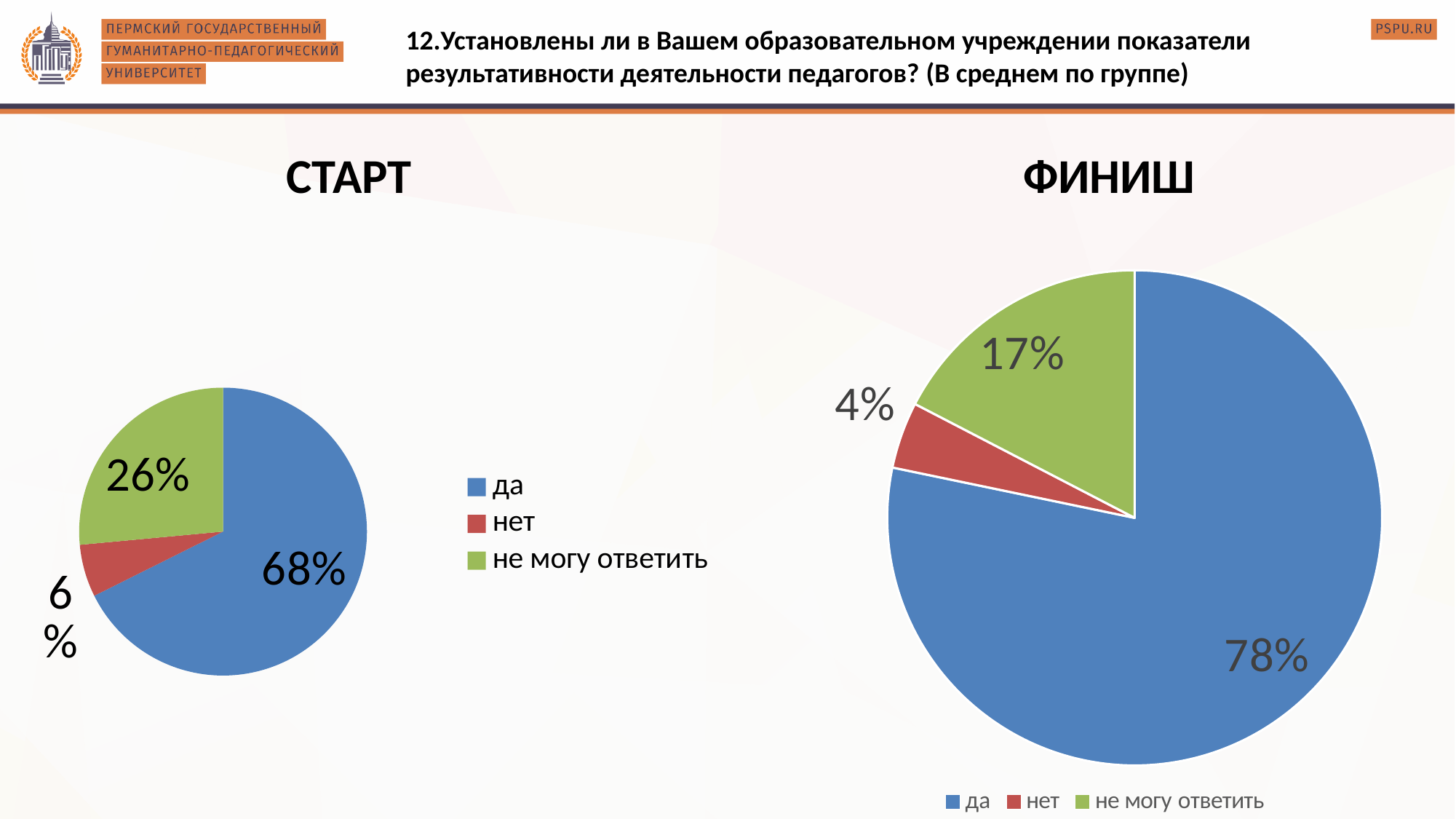
In the legend of the ФИНИШ chart, which colour represents "нет"? Red In the ФИНИШ pie chart, which answer has the largest slice? да What type of chart is used for the СТАРТ data? Pie chart How many slices does the ФИНИШ pie chart have? 3 Which chart shows a larger share for "не могу ответить", СТАРТ or ФИНИШ? СТАРТ What is the difference between the "да" share in the ФИНИШ chart and the "да" share in the СТАРТ chart? 10% In the СТАРТ pie chart, what share of respondents answered "да"? 68% In the СТАРТ pie chart, which answer has the smallest slice? нет In the СТАРТ pie chart, what is the difference between the "не могу ответить" share and the "нет" share? 20% In the ФИНИШ pie chart, what share of respondents answered "нет"? 4% In the ФИНИШ pie chart, what share of respondents answered "да"? 78% In the СТАРТ pie chart, what share of respondents answered "не могу ответить"? 26%